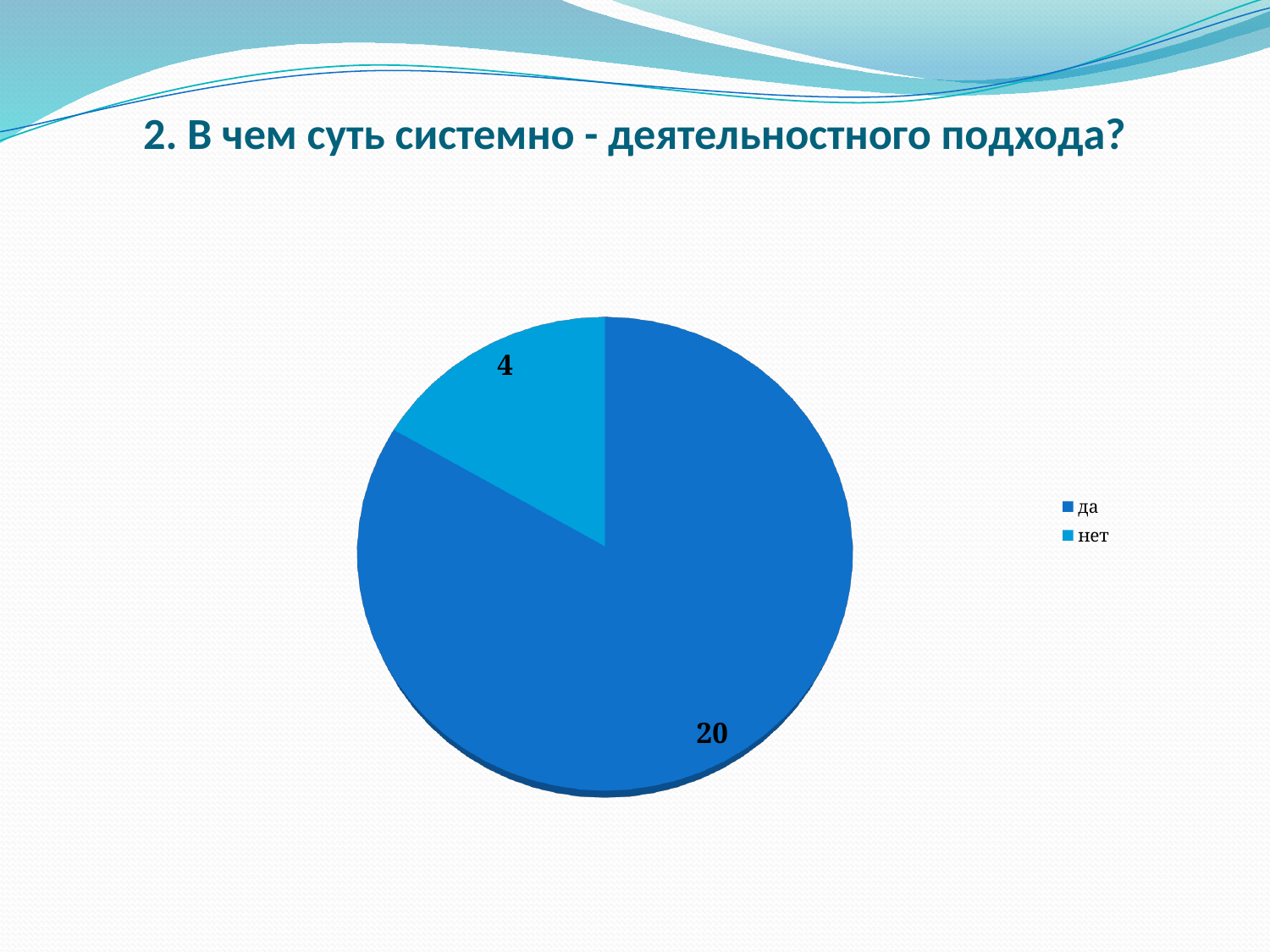
What share of the pie does the "нет" slice represent? 1/6 How many slices does the pie chart have? 2 What is the value for "да"? 20 What is the total of all slices in the pie chart? 24 How many entries does the legend list? 2 What is the value for "нет"? 4 What kind of chart is shown on the slide? pie chart Which category has the smallest slice? нет Which is larger, the value for "да" or the value for "нет"? да What is the difference between the values for "да" and "нет"? 16 Which category has the largest slice? да What is the title of the slide above the chart? 2. В чем суть системно - деятельностного подхода?